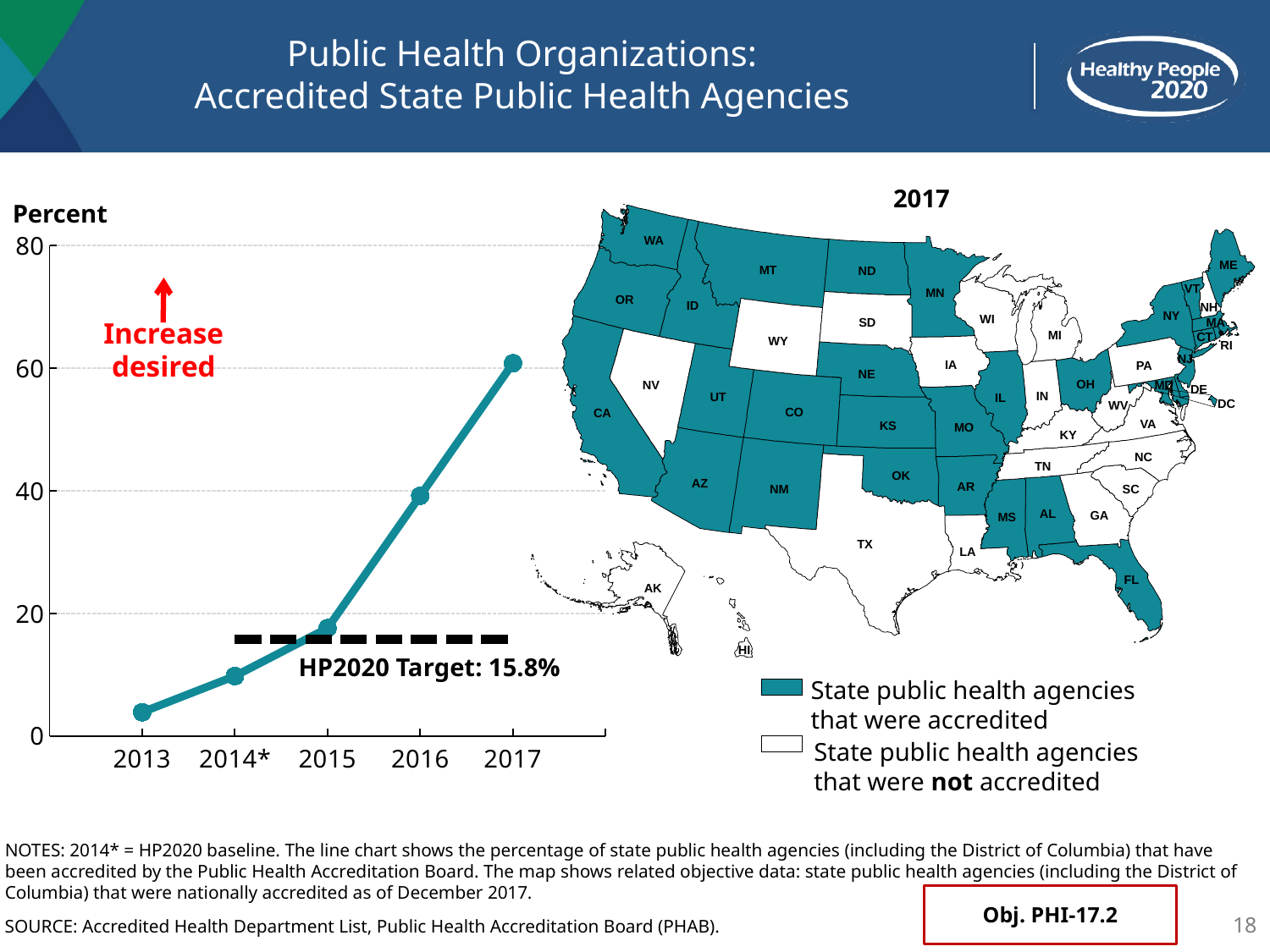
In the line chart, which year has the lowest value? 2013 In the line chart, which year has the highest value? 2017 In the line chart, which year has the larger value, 2015 or 2016? 2016 What kind of chart is shown on the left side of the slide? line chart In the line chart, how many years are plotted along the x axis? 5 What is the HP2020 Target value shown on the line chart? 15.8% On the map, is Texas (TX) shaded as a state public health agency that was accredited or not accredited? not accredited What is the label on the y axis of the line chart? Percent In the line chart, do the values rise or fall from 2013 to 2017? rise In the line chart, is the value for 2013 greater or less than 20? less